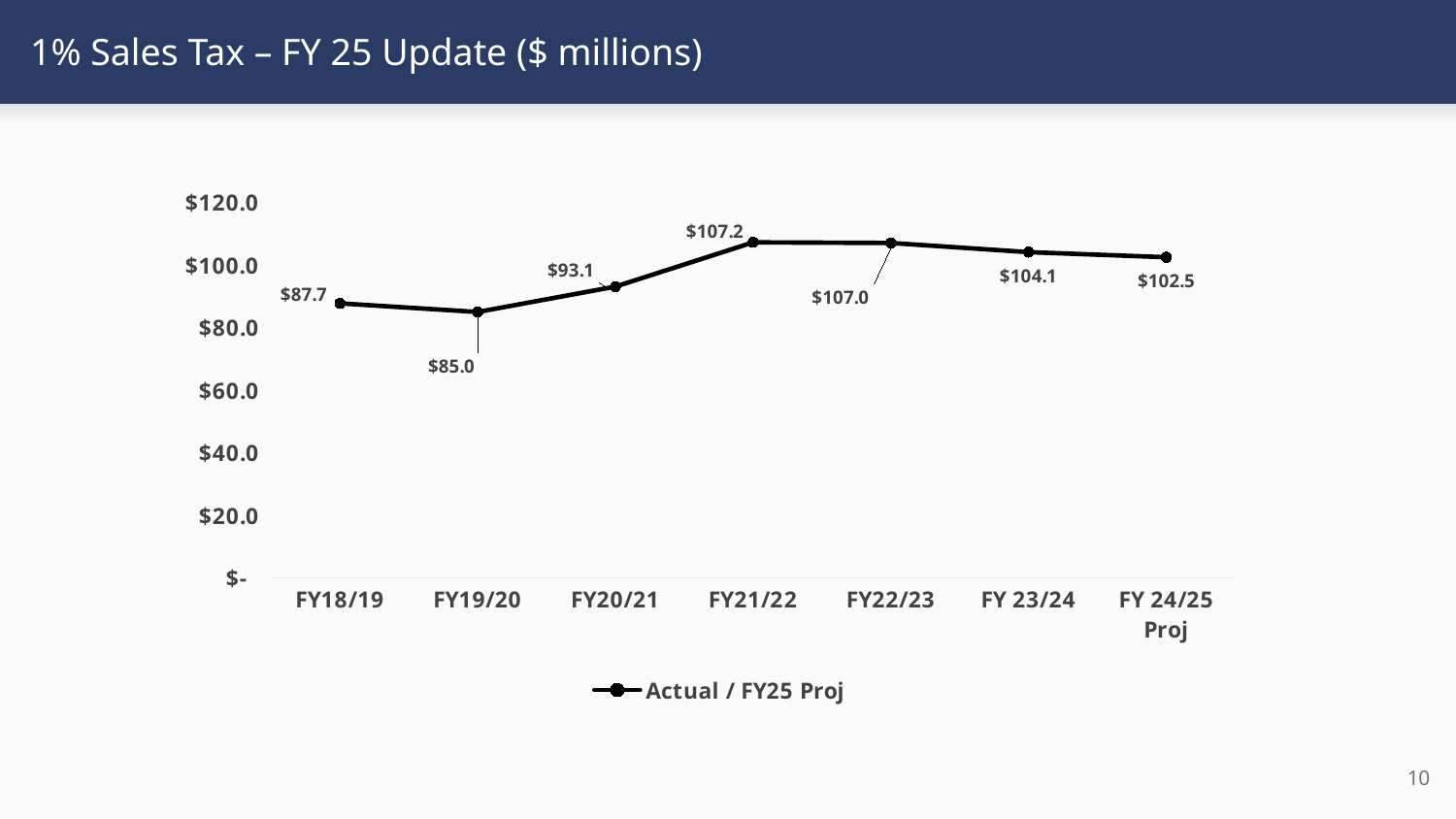
How many series does the legend list? 1 What is the value for FY20/21? $93.1 What is the value for FY 24/25 Proj? $102.5 Which fiscal year has the lowest value? FY19/20 What kind of chart is shown on the slide? line chart Is the value for FY19/20 greater or less than $100.0? less Which fiscal year has the highest value? FY21/22 What is the difference between the values for FY21/22 and FY18/19? $19.5 Which is larger, the value for FY22/23 or the value for FY 23/24? FY22/23 Do the values rise or fall from FY21/22 to FY 24/25 Proj? fall How many fiscal years are plotted on the x axis? 7 What is the value for FY18/19? $87.7